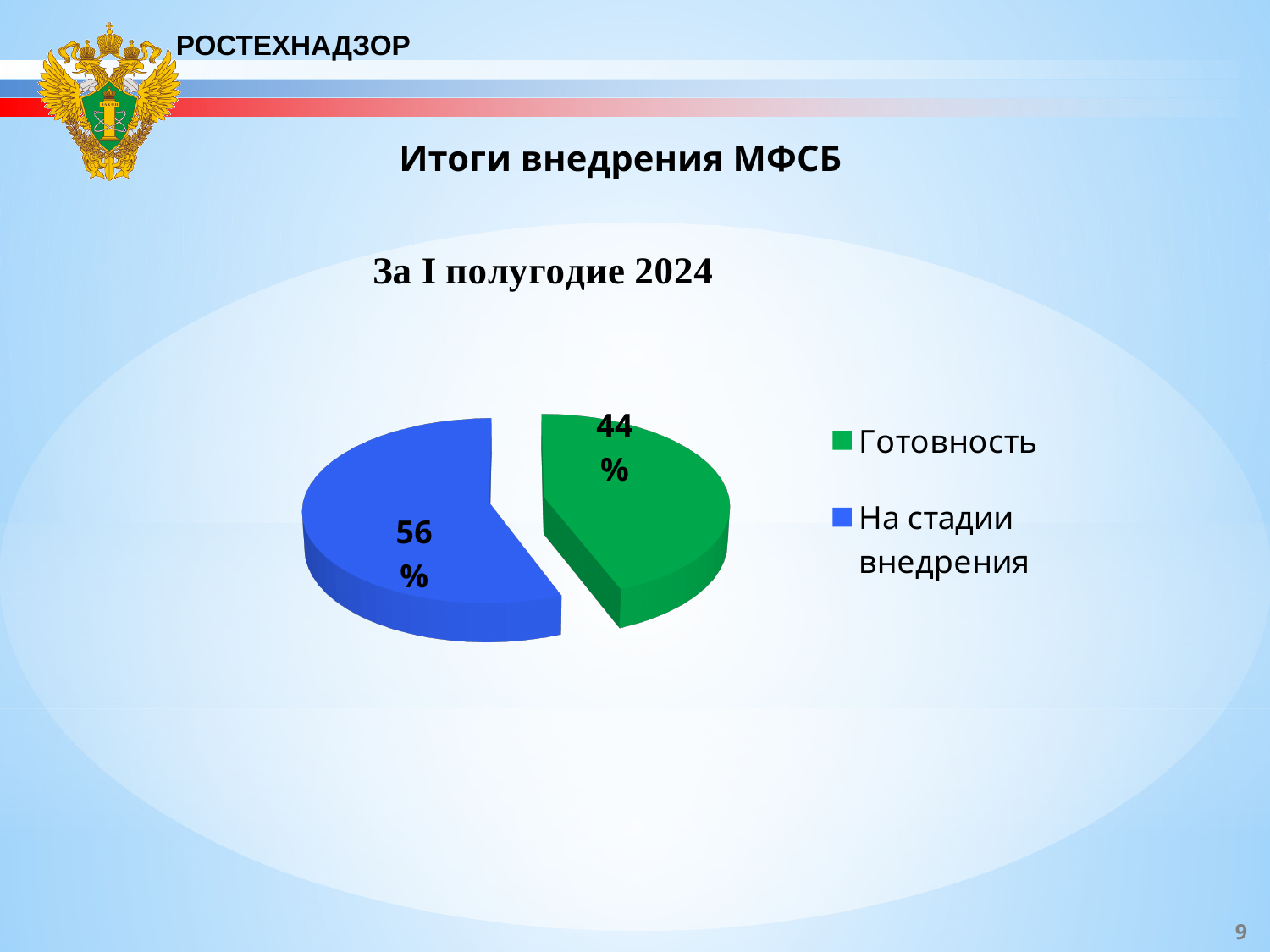
Which category has the smallest share of the pie? Готовность What kind of chart is shown on the slide? pie chart What is the total of the two slices shown? 100% What is the difference between the share for На стадии внедрения and the share for Готовность? 12% How many slices does the pie chart have? 2 What colour is the slice for Готовность? green Which category has the largest share of the pie? На стадии внедрения Which is larger, the share for Готовность or the share for На стадии внедрения? На стадии внедрения How many entries does the legend list? 2 What is the value for На стадии внедрения? 56% What is the value for Готовность? 44% What is the title of the chart? За I полугодие 2024